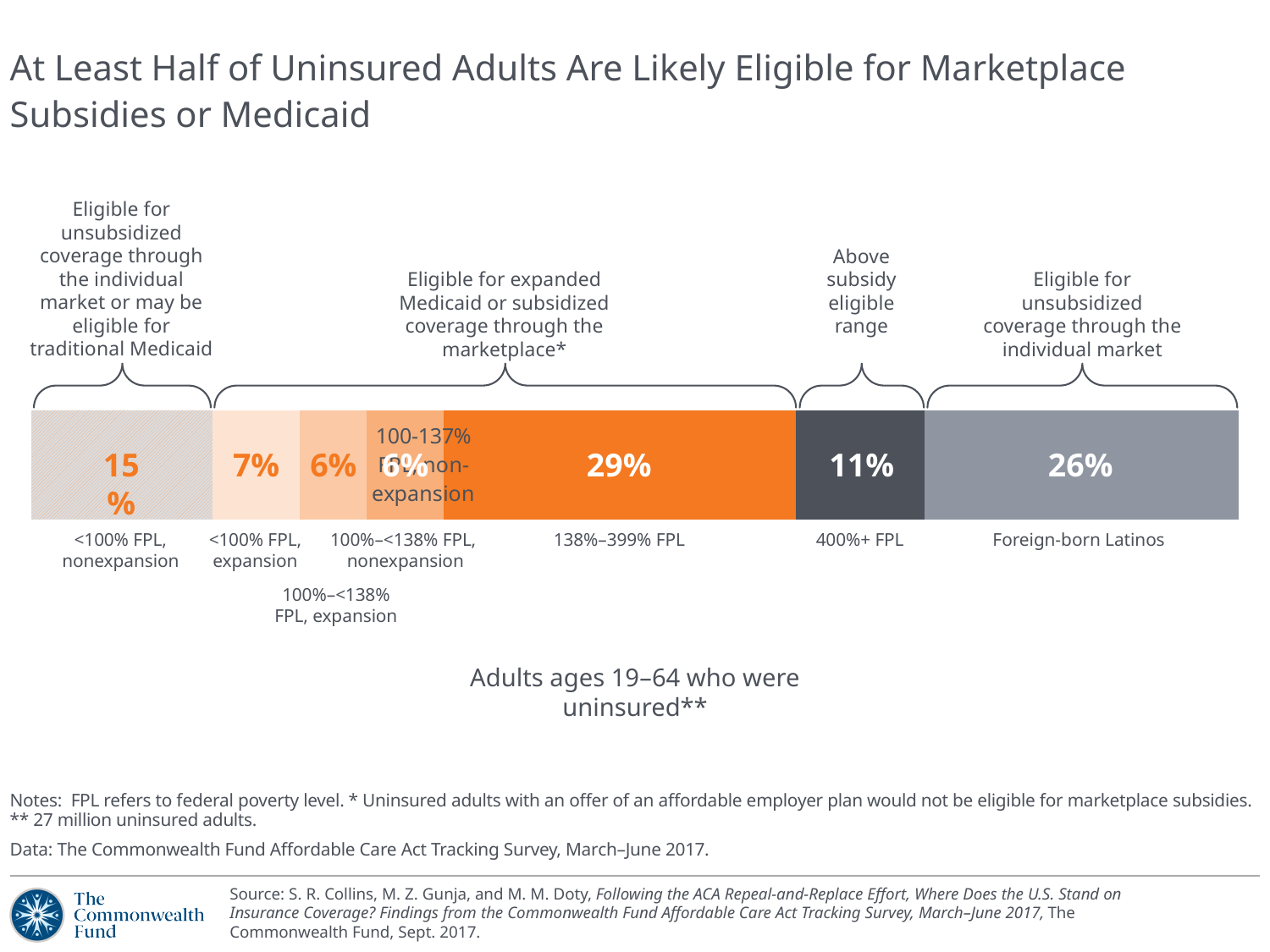
What percentage of uninsured adults are in the 138%–399% FPL group? 29% How many segments make up the bar? 7 What type of chart is shown on the slide? Stacked bar chart What share of uninsured adults are foreign-born Latinos? 26% How many percentage points larger is the 138%–399% FPL segment than the 400%+ FPL segment? 18 percentage points What is the value for the <100% FPL, expansion segment? 7% Which segment is labeled as being above the subsidy eligible range? 400%+ FPL What is the value for the <100% FPL, nonexpansion segment? 15% Which segment of the bar is the largest? 138%–399% FPL What percentage of uninsured adults are at 400%+ FPL? 11% Which is larger: the Foreign-born Latinos segment or the 400%+ FPL segment? Foreign-born Latinos What is the difference between the Foreign-born Latinos segment and the <100% FPL, nonexpansion segment? 11 percentage points